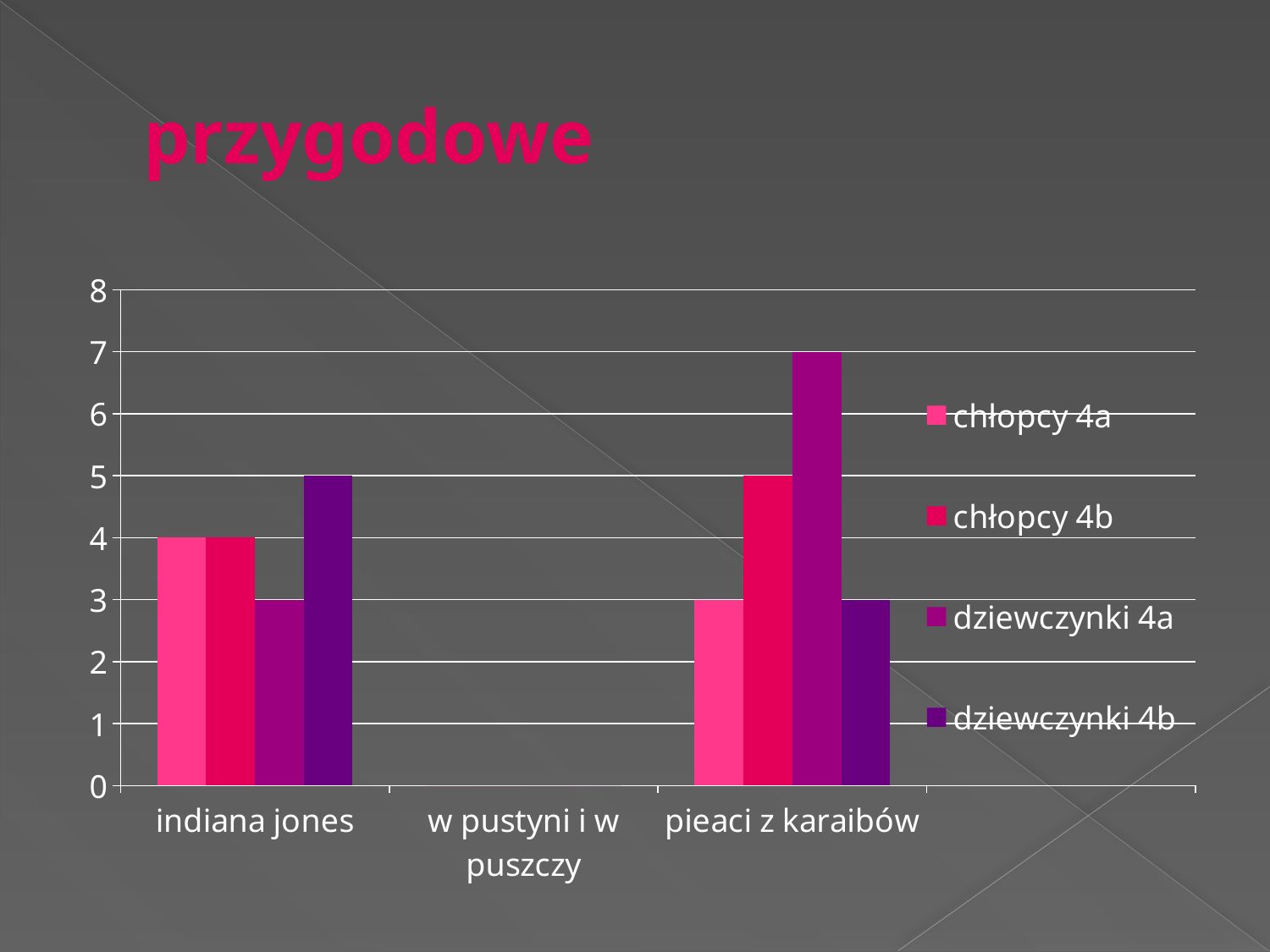
How many series does the legend list? 4 What is the value for dziewczynki 4b for indiana jones? 5 What is the value for dziewczynki 4a for pieaci z karaibów? 7 What kind of chart is shown on the slide? bar chart How many categories are shown on the x axis? 3 Which series has the lowest value for indiana jones? dziewczynki 4a What is the difference between dziewczynki 4a for pieaci z karaibów and dziewczynki 4a for indiana jones? 4 What is the title of the slide? przygodowe What is the value for chłopcy 4b for pieaci z karaibów? 5 What is the value for chłopcy 4a for indiana jones? 4 Which is larger: chłopcy 4b for indiana jones or chłopcy 4b for pieaci z karaibów? chłopcy 4b for pieaci z karaibów Which series has the highest value for pieaci z karaibów? dziewczynki 4a